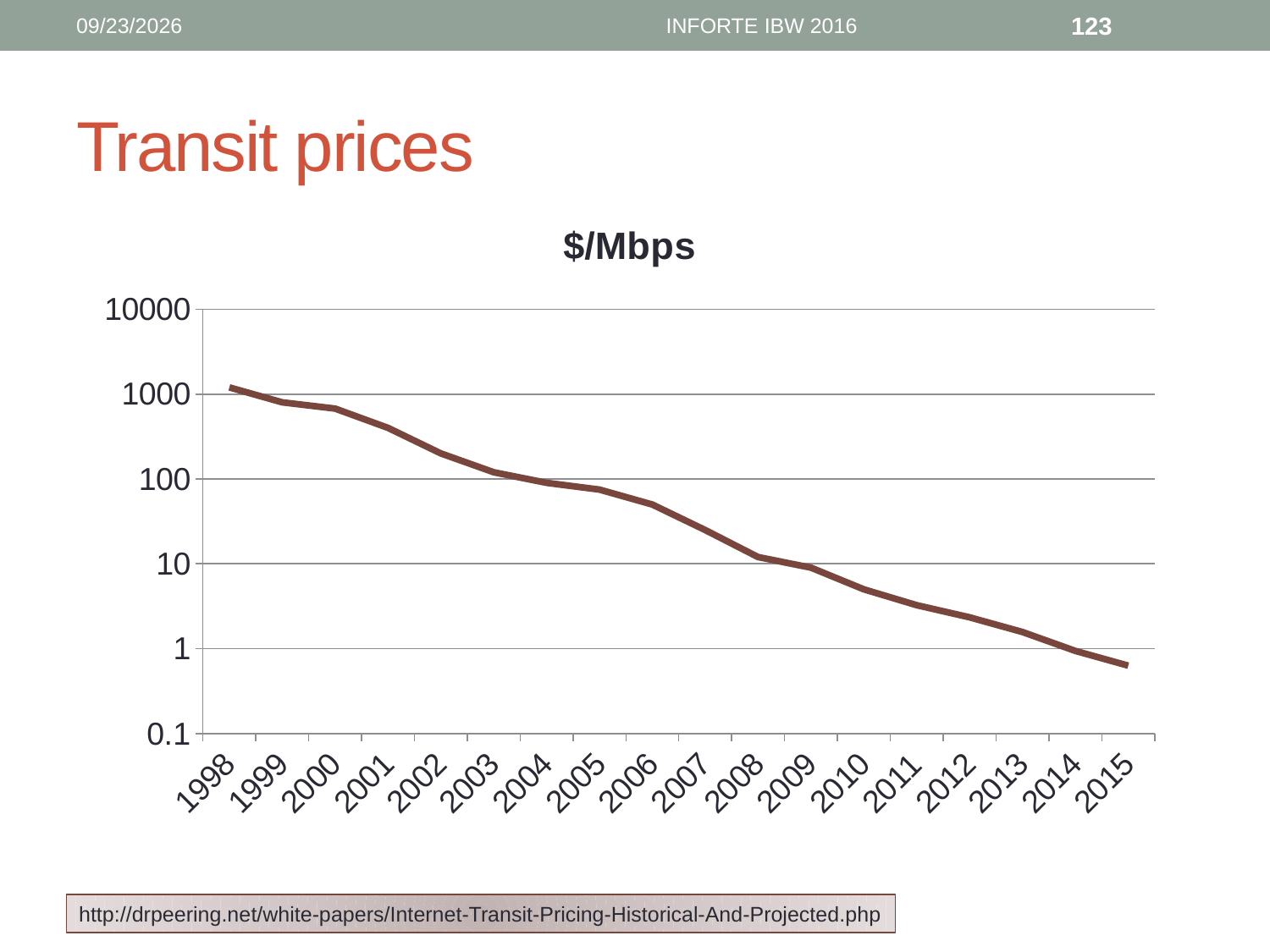
Is the value for 2015 greater or less than 1? less Which year has the lowest value? 2015 Which year has the larger value, 2000 or 2010? 2000 Is the value for 2010 greater or less than 10? less What is the title of the chart? $/Mbps Is the value for 2002 greater or less than 100? greater Do the values rise or fall from 1998 to 2015? fall What kind of chart is shown on the slide? line chart Which year has the highest value? 1998 How many years are plotted along the x axis? 18